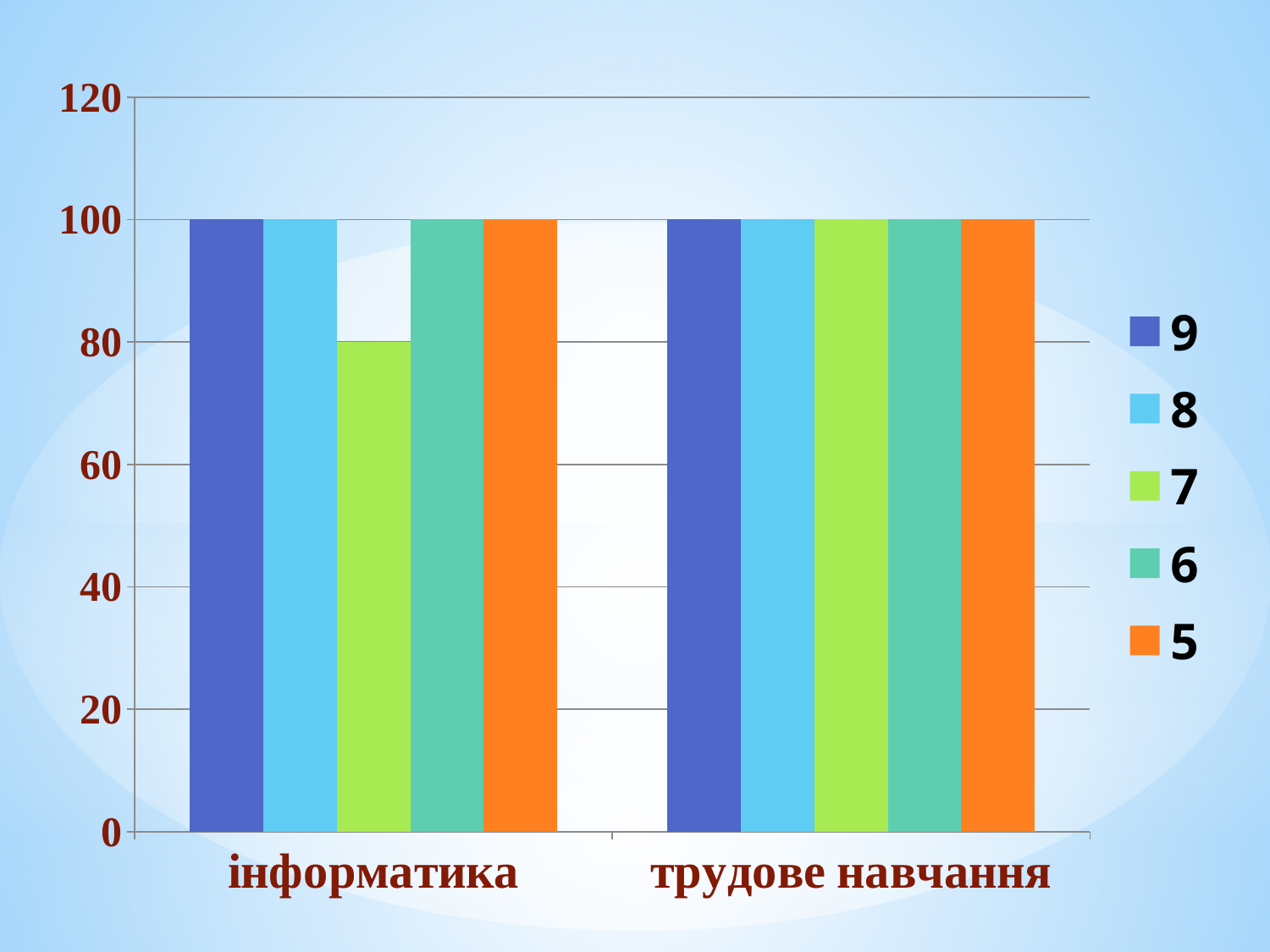
What is the value for series 7 in the трудове навчання category? 100 Which is larger: the value for series 7 in інформатика or the value for series 7 in трудове навчання? трудове навчання Which series has the lowest value in the інформатика category? 7 How many series does the legend list? 5 Is the value for series 7 in інформатика greater or less than 100? less What colour are the bars for series 5? orange What is the difference between the value for series 7 in трудове навчання and the value for series 7 in інформатика? 20 How many categories are shown on the x axis? 2 What is the value for series 9 in the інформатика category? 100 What is the value for series 5 in the трудове навчання category? 100 What is the value for series 7 in the інформатика category? 80 What kind of chart is shown on the slide? bar chart